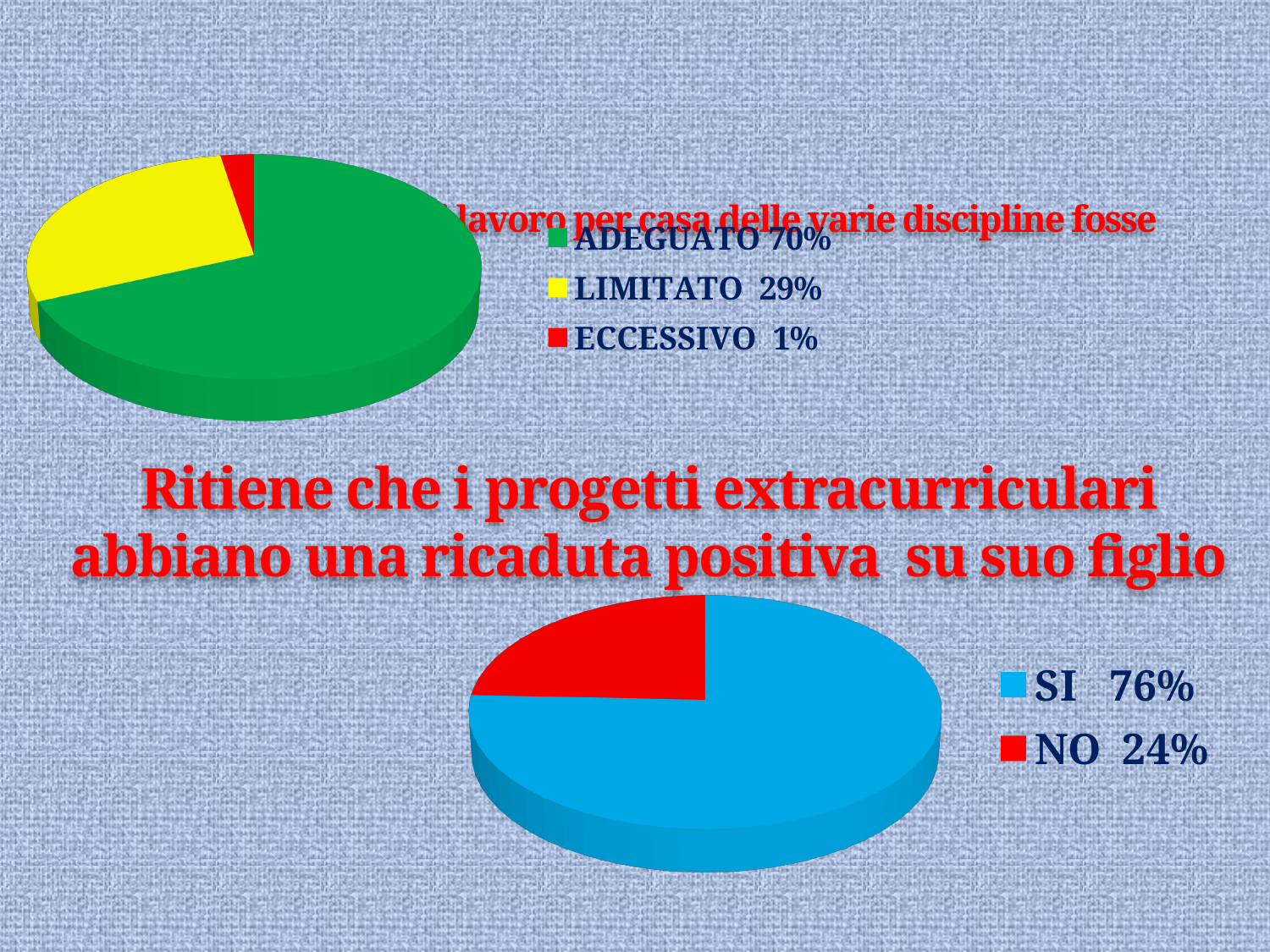
In the bottom pie chart titled 'Ritiene che i progetti extracurriculari abbiano una ricaduta positiva su suo figlio', what share answered SI? 76% In the bottom pie chart, which is larger, SI or NO? SI In the top-left pie chart, what is the difference between the ADEGUATO and LIMITATO shares? 41% In the top-left pie chart, what share is labelled ECCESSIVO? 1% What kind of chart is the chart at the top left of the slide? pie chart In the bottom pie chart titled 'Ritiene che i progetti extracurriculari abbiano una ricaduta positiva su suo figlio', what share answered NO? 24% In the top-left pie chart, what share is labelled ADEGUATO? 70% In the bottom pie chart, what colour is the SI slice? blue In the top-left pie chart, what share is labelled LIMITATO? 29% In the top-left pie chart, how many categories does the legend list? 3 In the top-left pie chart, which category has the largest share? ADEGUATO In the top-left pie chart, which category has the smallest share? ECCESSIVO